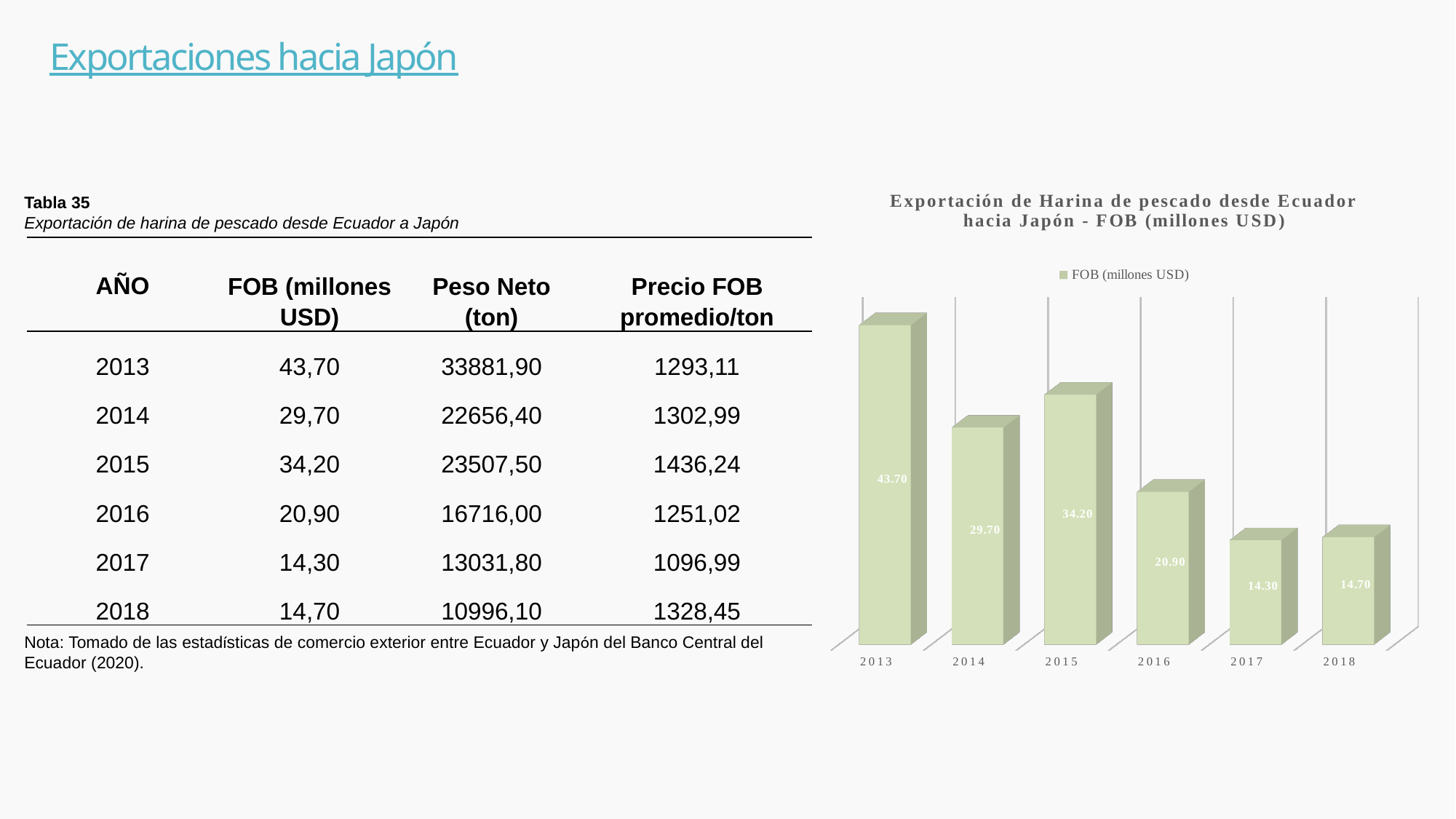
Which year has the highest FOB value in the chart? 2013 What is the FOB value (millones USD) shown for 2013 in the chart? 43.70 Which year has the lowest FOB value in the chart? 2017 How many series does the chart legend list? 1 What is the FOB value (millones USD) shown for 2016 in the chart? 20.90 How many years are plotted in the chart? 6 What is the difference between the FOB values for 2013 and 2014 in the chart? 14.00 Which year has a larger FOB value in the chart, 2014 or 2015? 2015 What is the FOB value (millones USD) shown for 2018 in the chart? 14.70 What is the legend entry shown in the chart? FOB (millones USD) What is the difference between the FOB values for 2015 and 2016 in the chart? 13.30 What type of chart is shown on the slide? bar chart